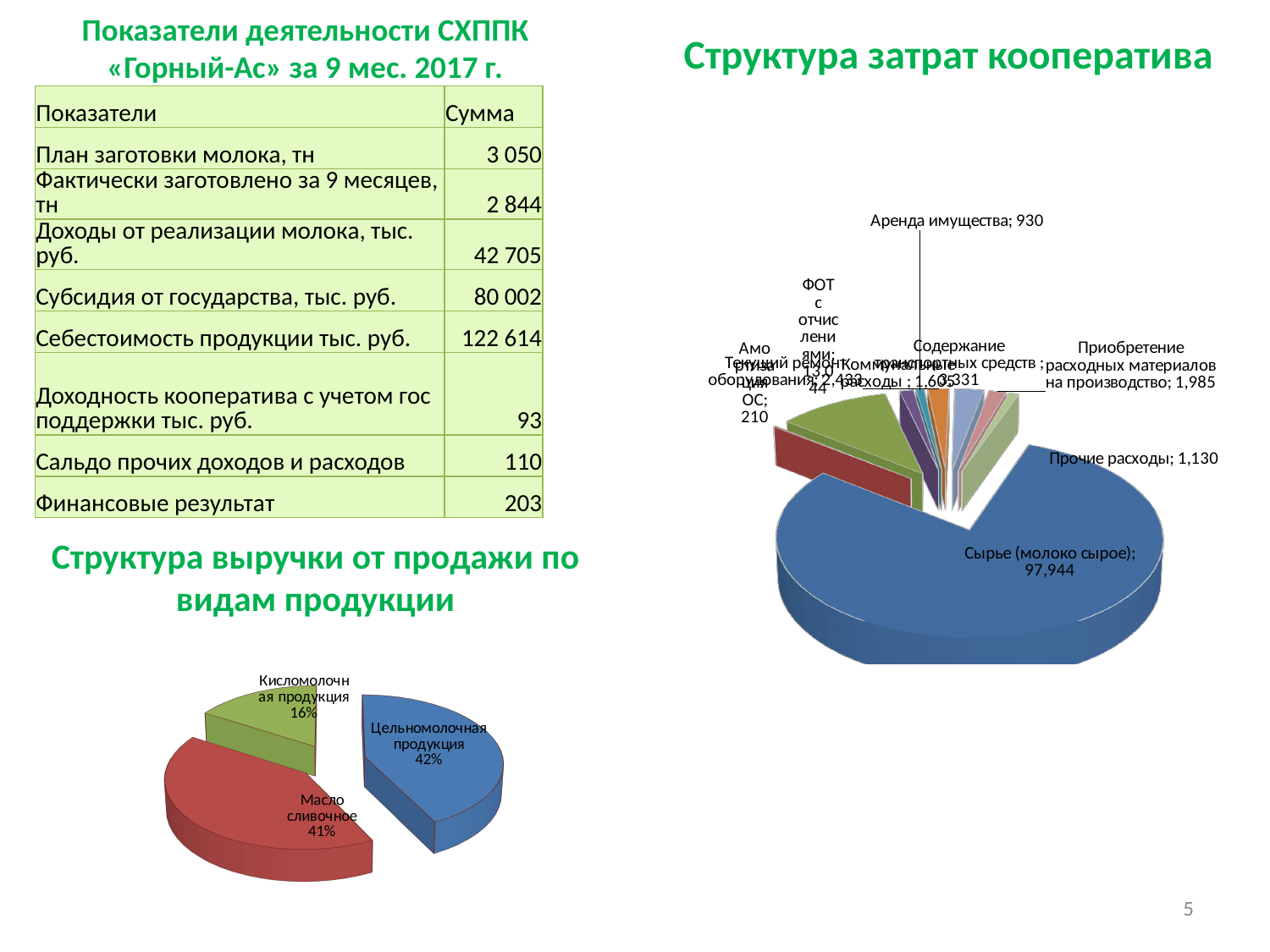
In the chart 'Структура выручки от продажи по видам продукции', what share does 'Кисломолочная продукция' have? 16% In the chart 'Структура затрат кооператива', what is the value for 'Прочие расходы'? 1,130 In the chart 'Структура затрат кооператива', which cost item is the largest? Сырье (молоко сырое) How many slices does the chart 'Структура выручки от продажи по видам продукции' have? 3 What kind of chart is 'Структура выручки от продажи по видам продукции'? Pie chart In the chart 'Структура выручки от продажи по видам продукции', what share does 'Цельномолочная продукция' have? 42% In the chart 'Структура выручки от продажи по видам продукции', which product type has the smallest share? Кисломолочная продукция In the chart 'Структура затрат кооператива', what is the value for 'Аренда имущества'? 930 In the chart 'Структура затрат кооператива', what is the difference between 'Аренда имущества' and 'Амортизация ОС'? 720 In the chart 'Структура затрат кооператива', what is the value for 'Сырье (молоко сырое)'? 97,944 In the chart 'Структура затрат кооператива', which is larger: 'Приобретение расходных материалов на производство' or 'Прочие расходы'? Приобретение расходных материалов на производство In the chart 'Структура выручки от продажи по видам продукции', what share does 'Масло сливочное' have? 41%